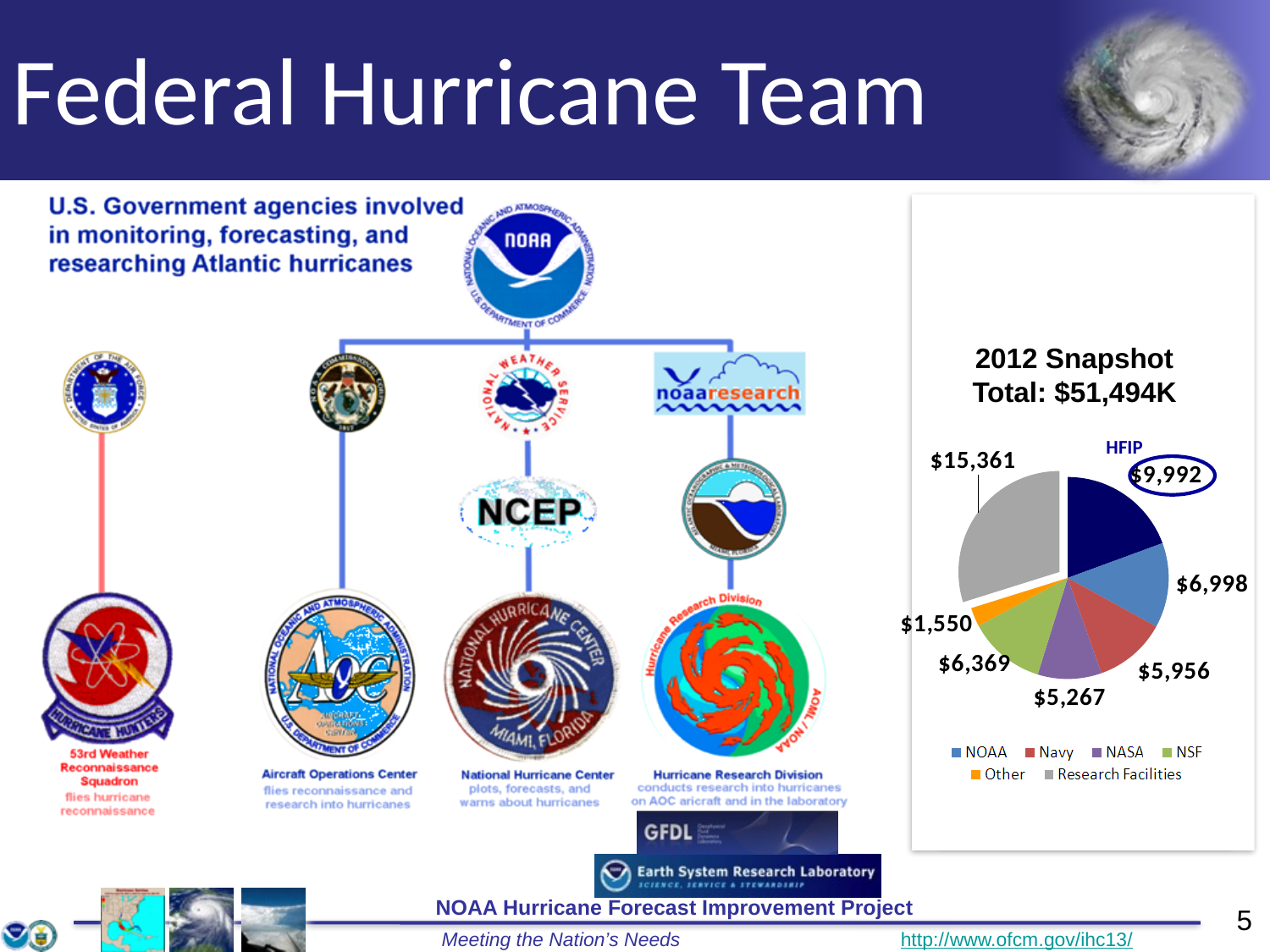
In the 2012 Snapshot pie chart, what is the value for NOAA? $6,998 How many slices does the 2012 Snapshot pie chart have? 7 In the 2012 Snapshot pie chart, what is the difference between the Research Facilities value and the HFIP value? $5,369 What kind of chart is shown in the 2012 Snapshot panel? pie chart How many entries does the legend of the 2012 Snapshot pie chart list? 6 In the 2012 Snapshot pie chart, what is the value for Other? $1,550 What total is stated in the title of the 2012 Snapshot pie chart? $51,494K In the 2012 Snapshot pie chart, which category has the smallest slice? Other In the 2012 Snapshot pie chart, which category has the largest slice? Research Facilities In the 2012 Snapshot pie chart, which is larger, NSF or NASA? NSF In the 2012 Snapshot pie chart, what is the value for Research Facilities? $15,361 In the 2012 Snapshot pie chart, what is the value of the slice labelled HFIP? $9,992